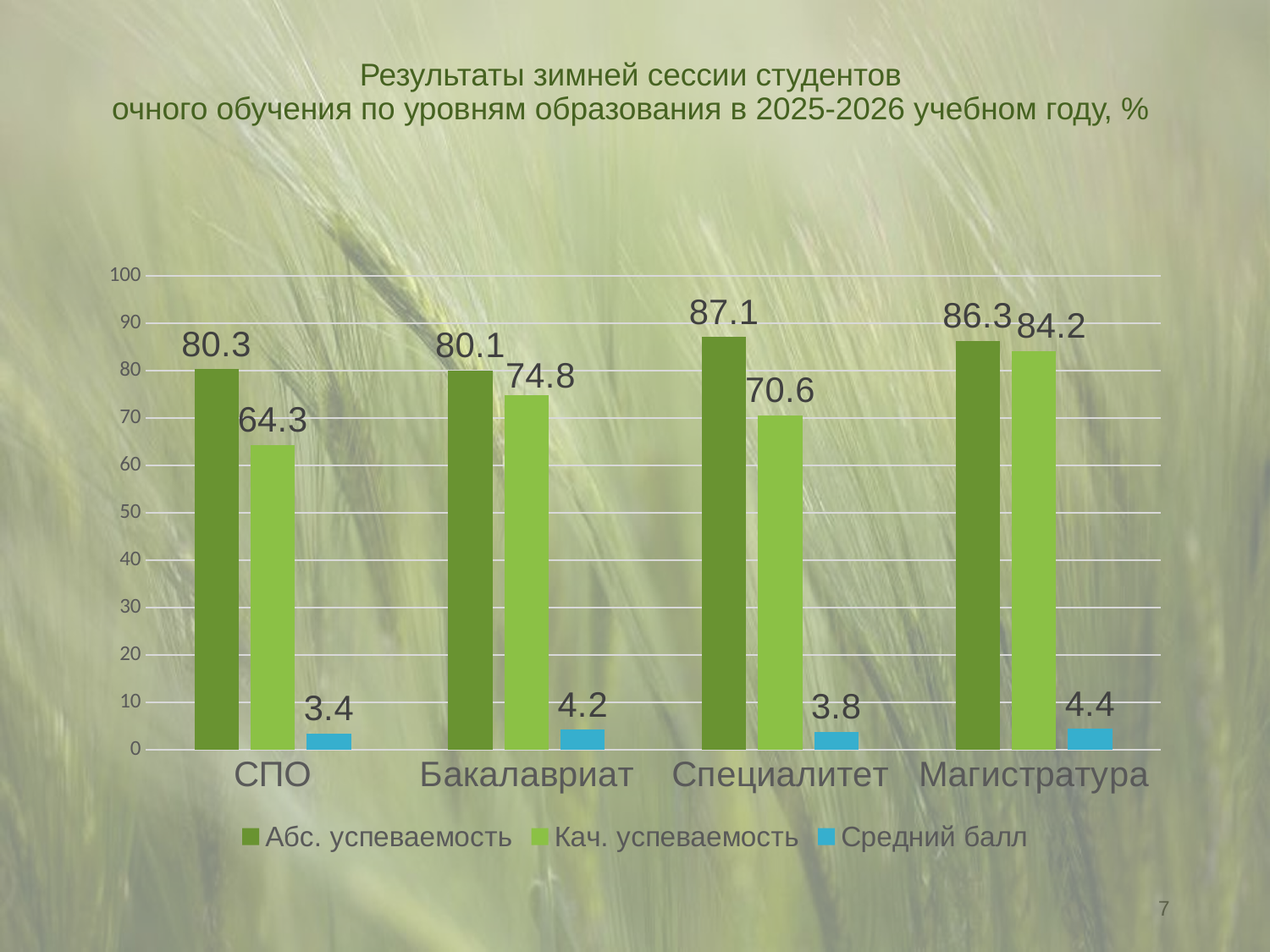
What is the value of Средний балл for Магистратура? 4.4 What colour are the bars for Средний балл? blue What is the value of Абс. успеваемость for Специалитет? 87.1 Which category has the lowest Средний балл? СПО How many series does the legend list? 3 Which category has the highest Кач. успеваемость? Магистратура Is the value of Кач. успеваемость for СПО greater or less than 70? less Which is larger: Кач. успеваемость for Бакалавриат or for Специалитет? Бакалавриат What is the value of Кач. успеваемость for СПО? 64.3 What kind of chart is shown on the slide? bar chart What is the difference between Абс. успеваемость and Кач. успеваемость for Бакалавриат? 5.3 How many categories are shown on the x axis? 4